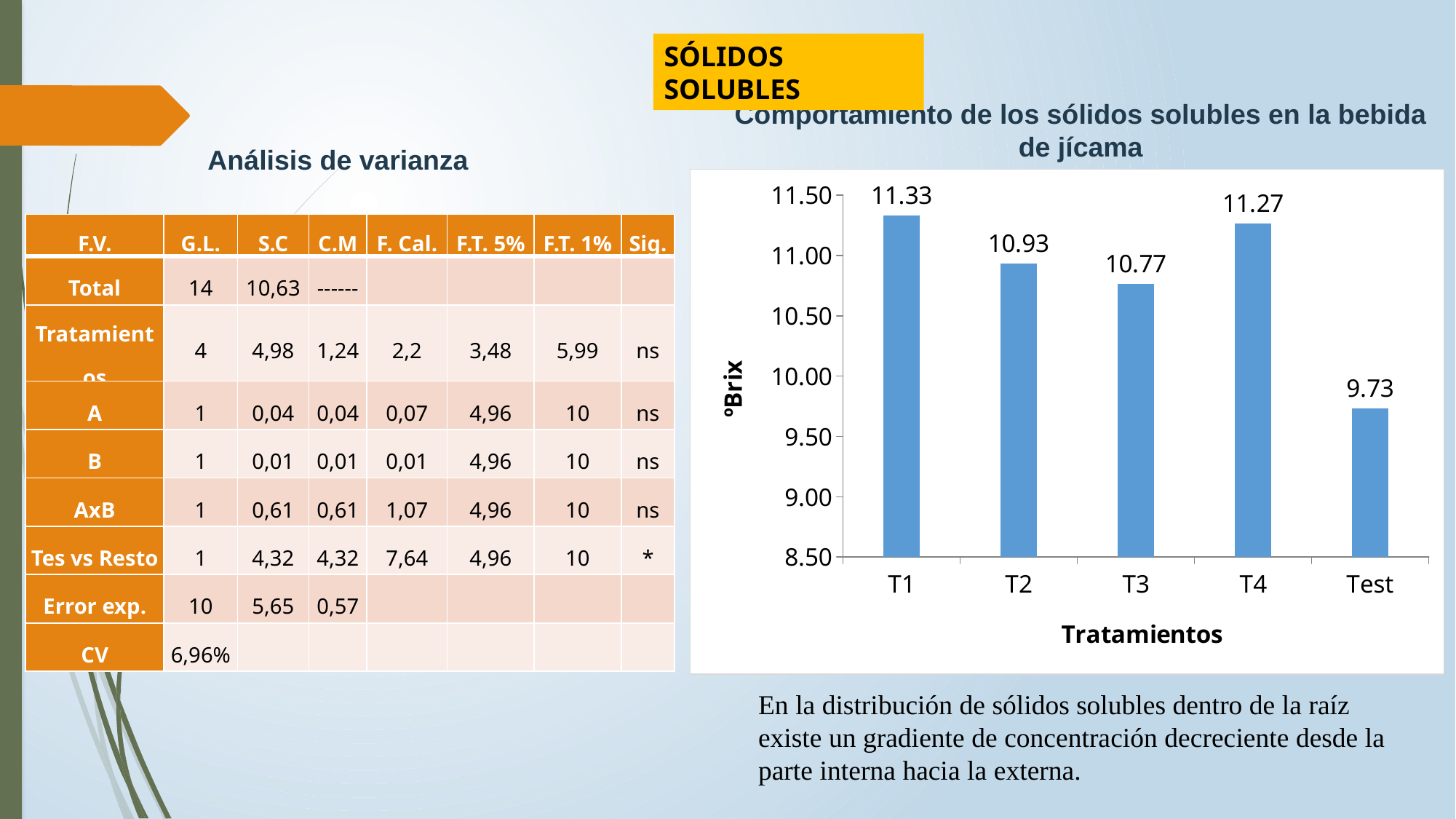
What is the value for T1 in the chart? 11.33 Which treatment has the lowest value in the chart? Test What is the difference between the values for T2 and T3? 0.16 Is the value for Test greater or less than 10.00? less What is the label of the y axis of the chart? °Brix What is the value for Test in the chart? 9.73 What is the difference between the values for T1 and Test? 1.60 Which is larger, the value for T2 or the value for T4? T4 How many treatments are shown on the x axis of the chart? 5 What kind of chart is shown on the slide? bar chart Which treatment has the highest value in the chart? T1 What is the value for T3 in the chart? 10.77